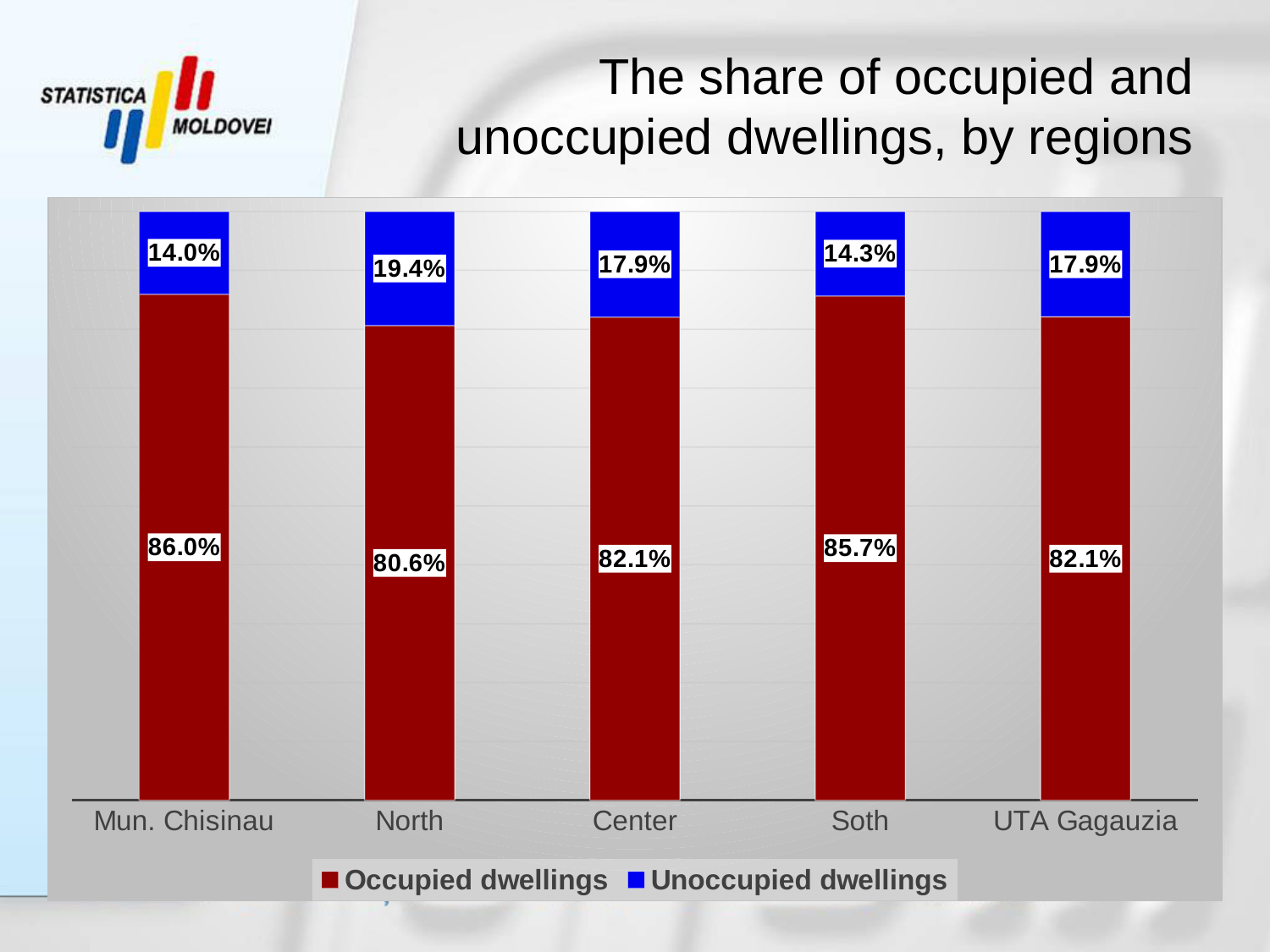
Which region has the lowest share of occupied dwellings? North What kind of chart is shown on the slide? Stacked bar chart What is the share of unoccupied dwellings in UTA Gagauzia? 17.9% Which has a larger share of unoccupied dwellings, Center or Soth? Center What is the share of unoccupied dwellings in North? 19.4% What is the difference between the share of occupied dwellings in Mun. Chisinau and in North? 5.4% What is the share of occupied dwellings in Soth? 85.7% What is the share of occupied dwellings in Mun. Chisinau? 86.0% Which region has the highest share of unoccupied dwellings? North How many series does the legend list? 2 Which region has the highest share of occupied dwellings? Mun. Chisinau How many regions are shown on the chart? 5